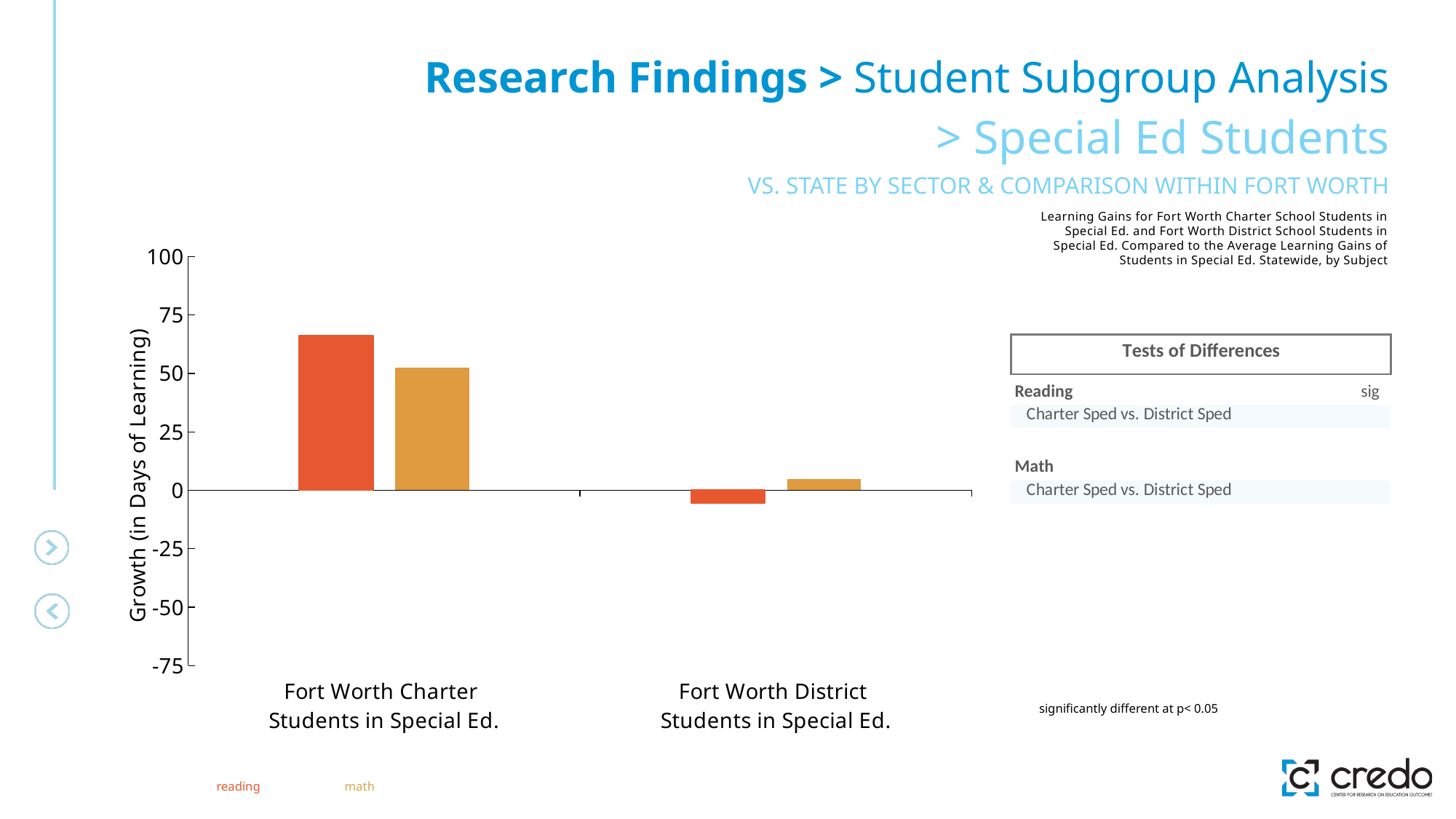
How many categories are shown on the x axis of the chart? 2 How many series does the chart's legend list? 2 For Fort Worth Charter Students in Special Ed., which is larger, the reading value or the math value? reading Is the reading value for Fort Worth District Students in Special Ed. greater or less than 0? less Is the math value for Fort Worth Charter Students in Special Ed. greater or less than 75? less Is the math value for Fort Worth District Students in Special Ed. greater or less than 25? less Which series does the orange-red colour represent in the chart? reading Which bar in the chart has the lowest value? reading for Fort Worth District Students in Special Ed. Which category has the higher reading value, Fort Worth Charter Students in Special Ed. or Fort Worth District Students in Special Ed.? Fort Worth Charter Students in Special Ed. What kind of chart is shown on the slide? bar chart What is the label of the chart's y axis? Growth (in Days of Learning)